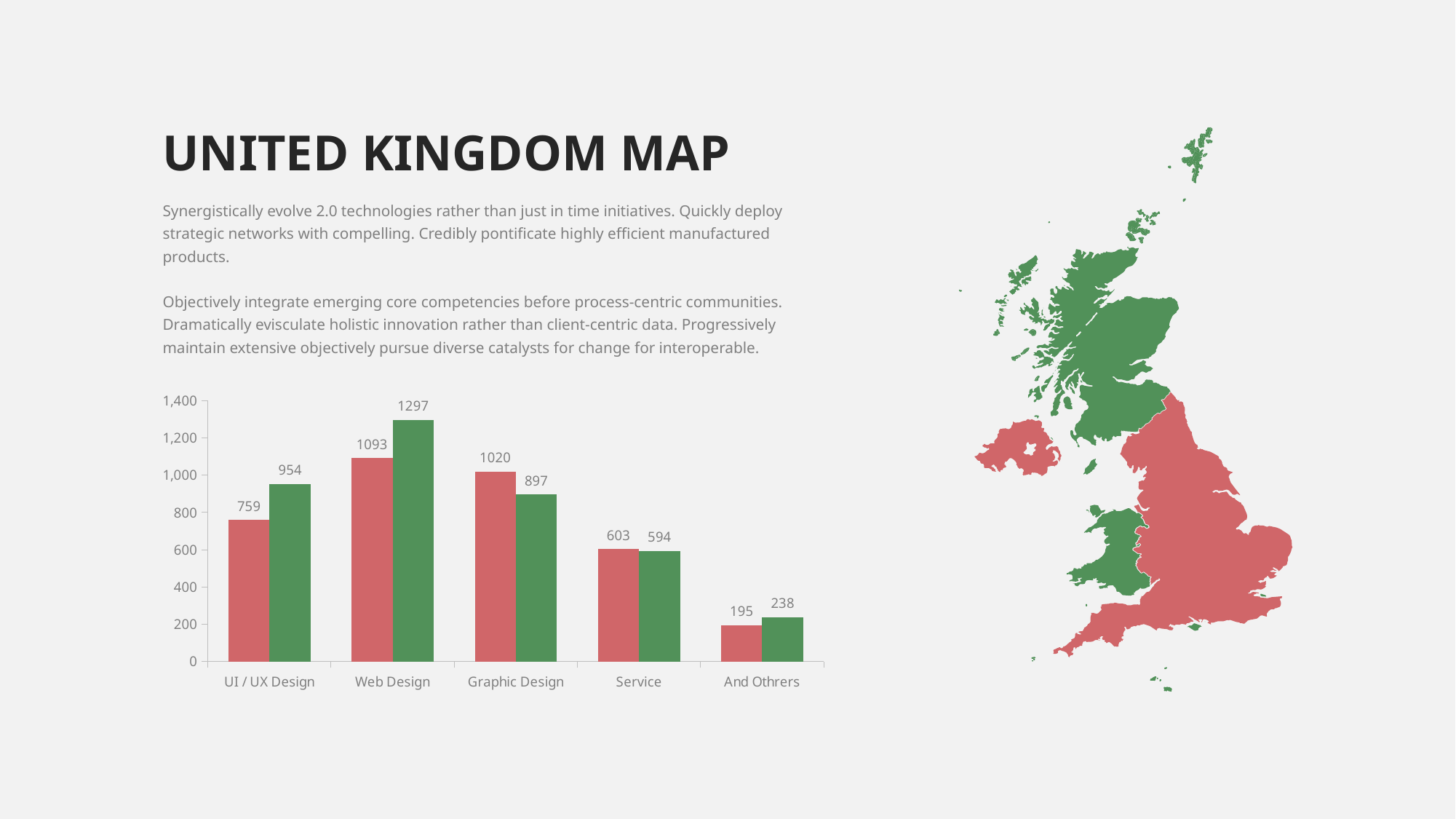
What is the difference between the green bar and the red bar for Graphic Design? 123 How many categories are shown on the x axis of the chart? 5 What is the value of the red bar for Web Design? 1093 What is the value of the red bar for Service? 603 What is the value of the green bar for And Othrers? 238 For Graphic Design, which is larger, the red bar or the green bar? the red bar Which category has the lowest red bar? And Othrers What kind of chart is shown on the slide? bar chart Which category has the highest green bar? Web Design What is the difference between the red bars for Web Design and UI / UX Design? 334 What is the value of the green bar for UI / UX Design? 954 What is the highest value shown on the chart's y axis? 1,400